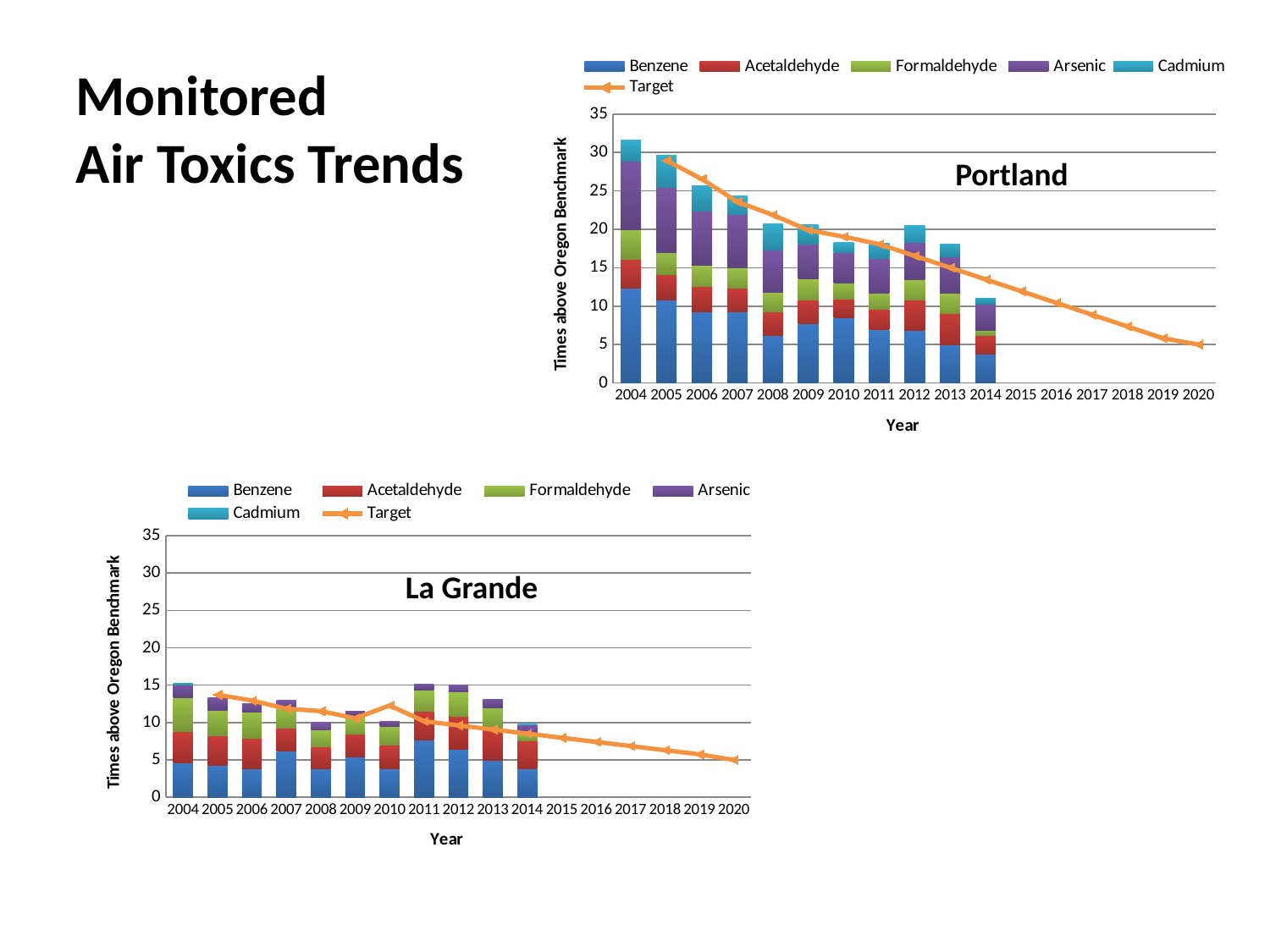
In the Portland chart, is the total stacked value for 2004 greater or less than 30? greater What type of chart is the Portland chart? stacked bar chart with a line In the Portland chart, which year has the tallest stacked bar? 2004 Comparing the 2004 stacked bars, which chart shows the larger total, Portland or La Grande? Portland How many series does the legend of the La Grande chart list? 6 In the La Grande chart, is the total stacked value for 2004 greater or less than 10? greater In the Portland chart, is the total stacked value for 2014 greater or less than 15? less In the Portland chart, which year has the shortest stacked bar? 2014 In the Portland chart, does the Target line rise or fall from 2005 to 2020? fall What is the label on the y axis of the La Grande chart? Times above Oregon Benchmark In the Portland chart, how many years have stacked bars plotted? 11